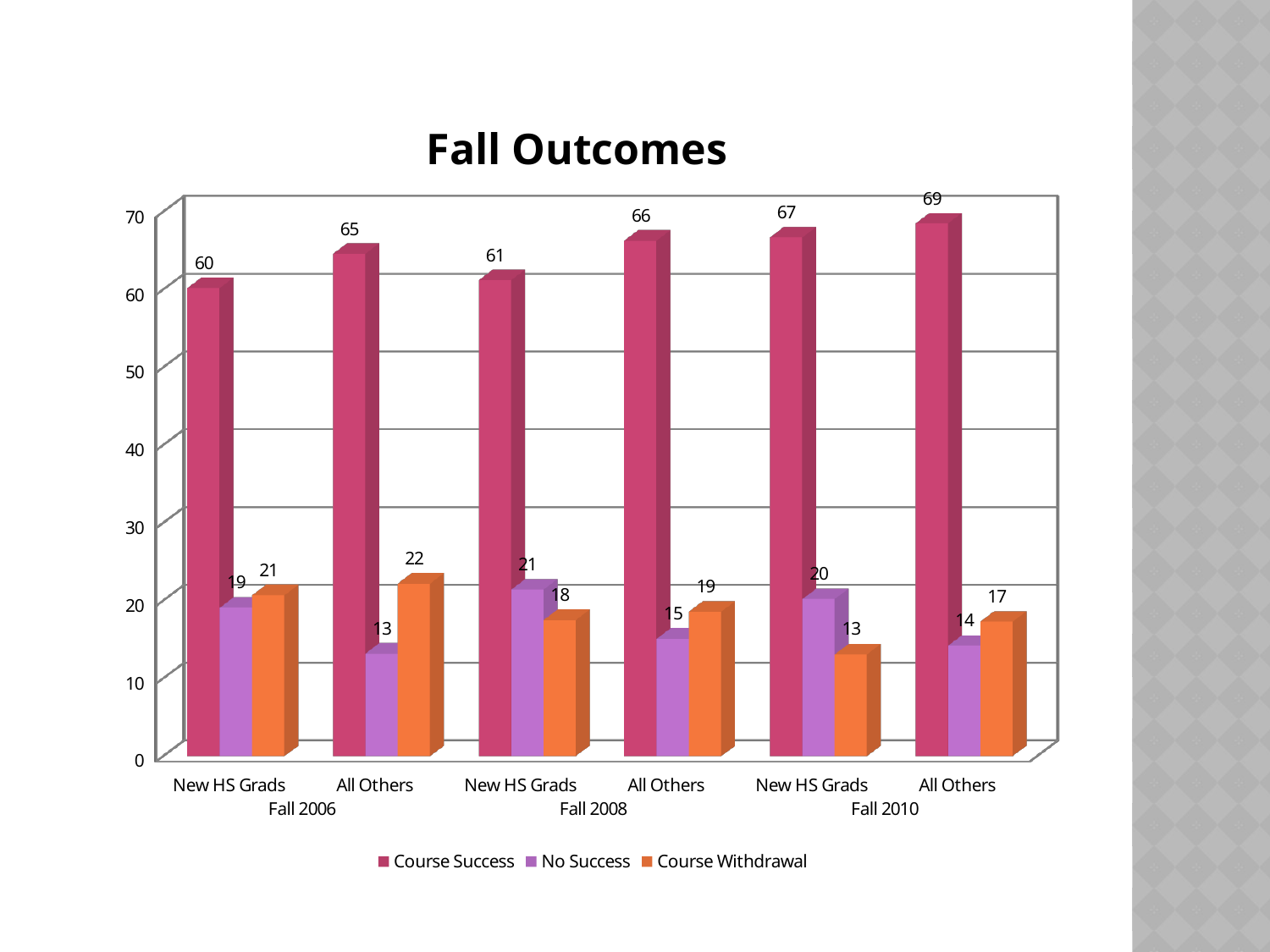
How many series does the legend list? 3 How many categories are shown on the x axis? 6 Does the Course Success value for All Others rise or fall from Fall 2006 to Fall 2010? rise What is the Course Success value for New HS Grads in Fall 2006? 60 What is the Course Withdrawal value for All Others in Fall 2006? 22 What is the difference between the Course Success values for All Others and New HS Grads in Fall 2008? 5 What is the No Success value for All Others in Fall 2010? 14 What kind of chart is this? bar chart What is the title of the chart? Fall Outcomes Which group and term has the highest Course Success value? All Others, Fall 2010 Which is larger: the No Success value for New HS Grads in Fall 2008 or the No Success value for New HS Grads in Fall 2010? New HS Grads in Fall 2008 Which group and term has the lowest Course Withdrawal value? New HS Grads, Fall 2010